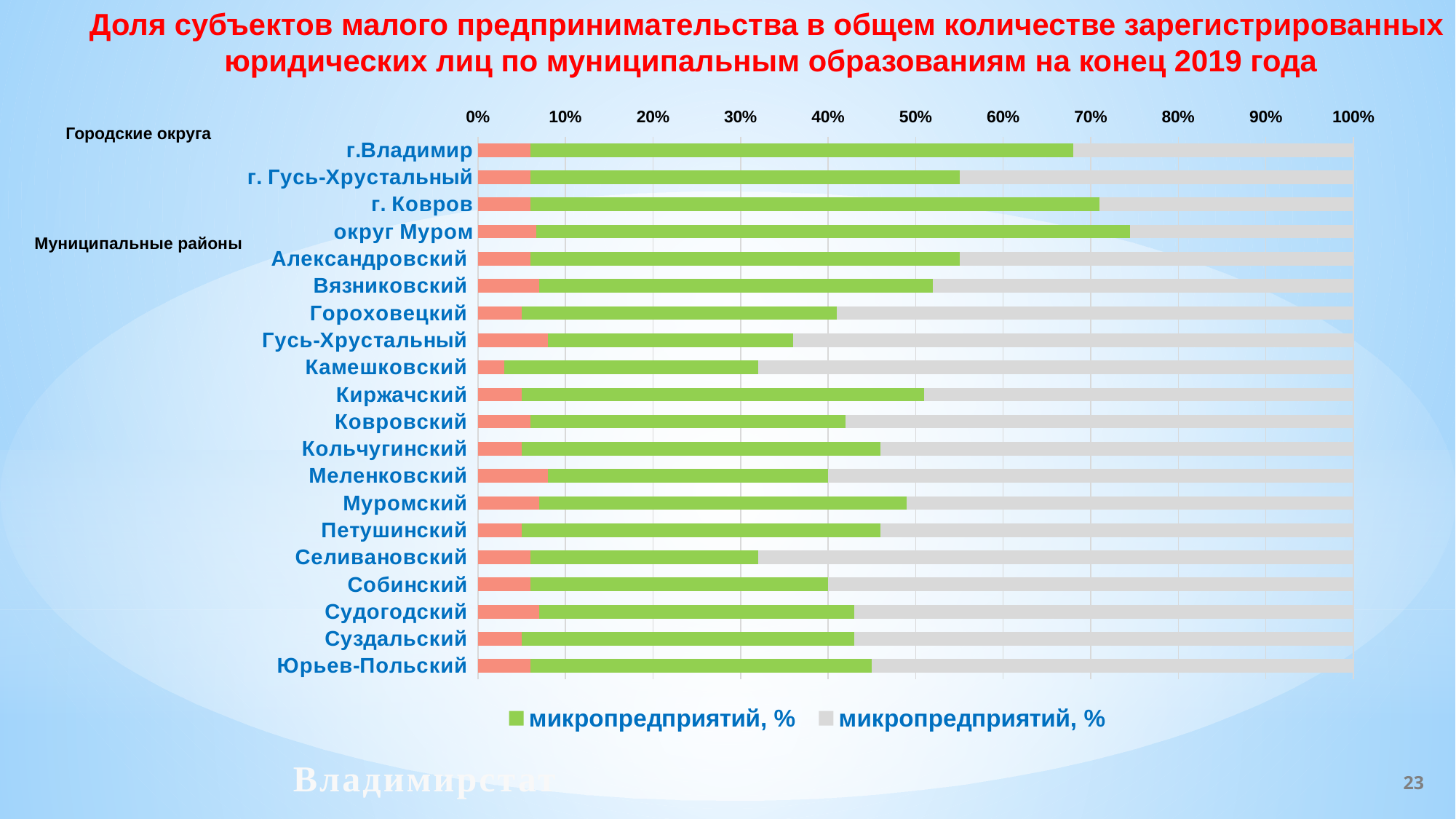
Is the combined red-and-green bar for Гусь-Хрустальный (district) greater or less than 40%? less Is the combined red-and-green bar for Кольчугинский greater or less than 50%? less Which municipality has the longest combined red-and-green bar (highest share of small businesses)? округ Муром Which has the longer combined red-and-green bar: г.Владимир or г. Гусь-Хрустальный? г.Владимир What is the highest value shown on the percentage axis? 100% Is the combined red-and-green bar for Камешковский greater or less than 40%? less How many series does the legend list? 2 Which has the longer combined red-and-green bar: Киржачский or Селивановский? Киржачский What kind of chart is shown on the slide? Stacked bar chart How many municipalities (categories) are plotted on the chart? 20